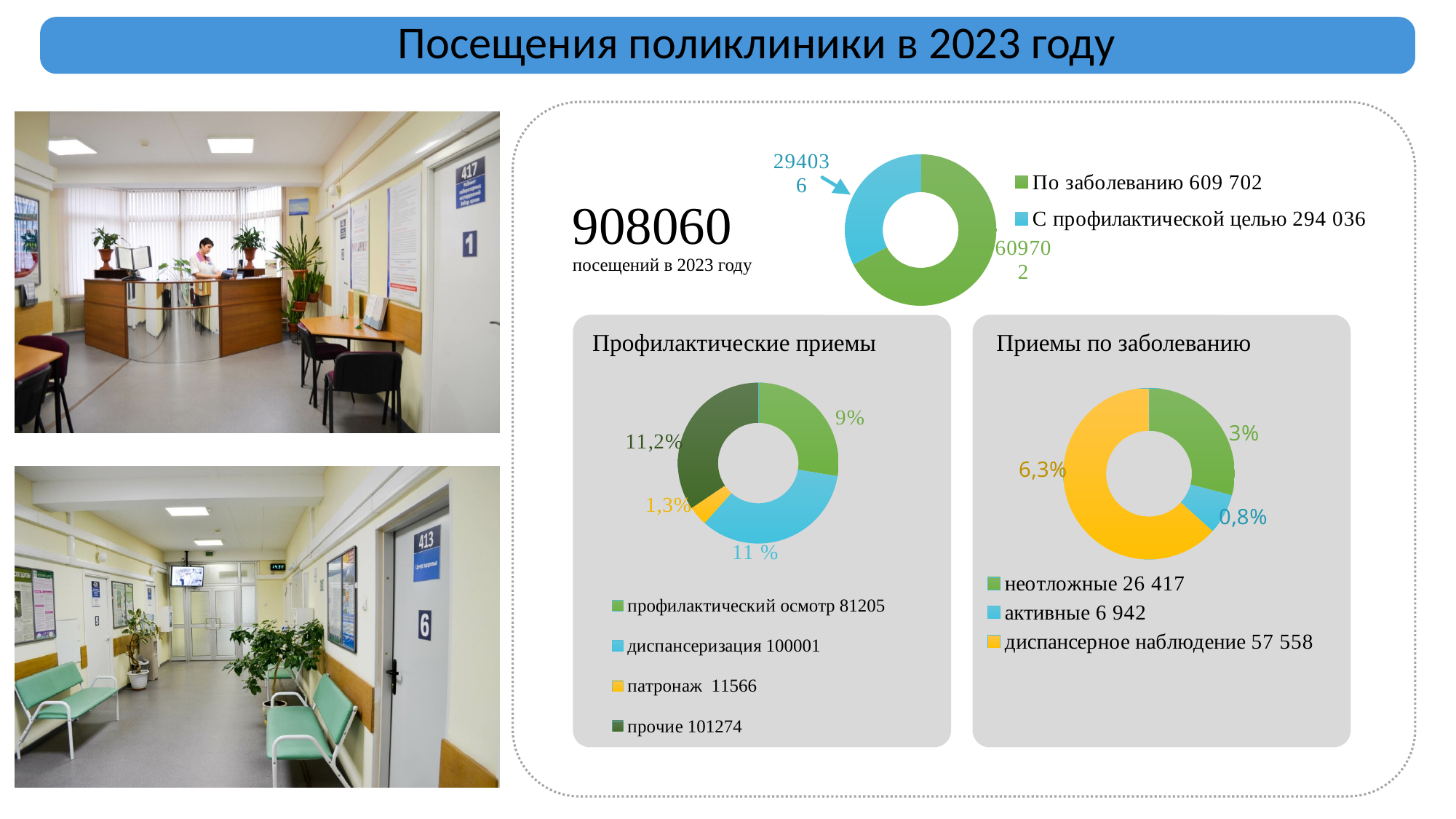
On the 'Профилактические приемы' chart, which category has the smallest value? патронаж On the 'Приемы по заболеванию' chart, what is the difference between 'диспансерное наблюдение' and 'активные'? 50 616 On the top chart, how many visits were 'С профилактической целью'? 294 036 On the top chart, which category is larger: 'По заболеванию' or 'С профилактической целью'? По заболеванию How many categories does the 'Профилактические приемы' chart show? 4 On the 'Профилактические приемы' chart, what is the value for 'патронаж'? 11566 On the 'Профилактические приемы' chart, what is the value for 'диспансеризация'? 100001 On the top chart, how many visits were 'По заболеванию'? 609 702 What type of chart is the 'Приемы по заболеванию' chart? doughnut chart On the 'Приемы по заболеванию' chart, what is the value for 'неотложные'? 26 417 On the top chart, what is the difference between visits 'По заболеванию' and 'С профилактической целью'? 315 666 On the 'Приемы по заболеванию' chart, which category has the largest value? диспансерное наблюдение